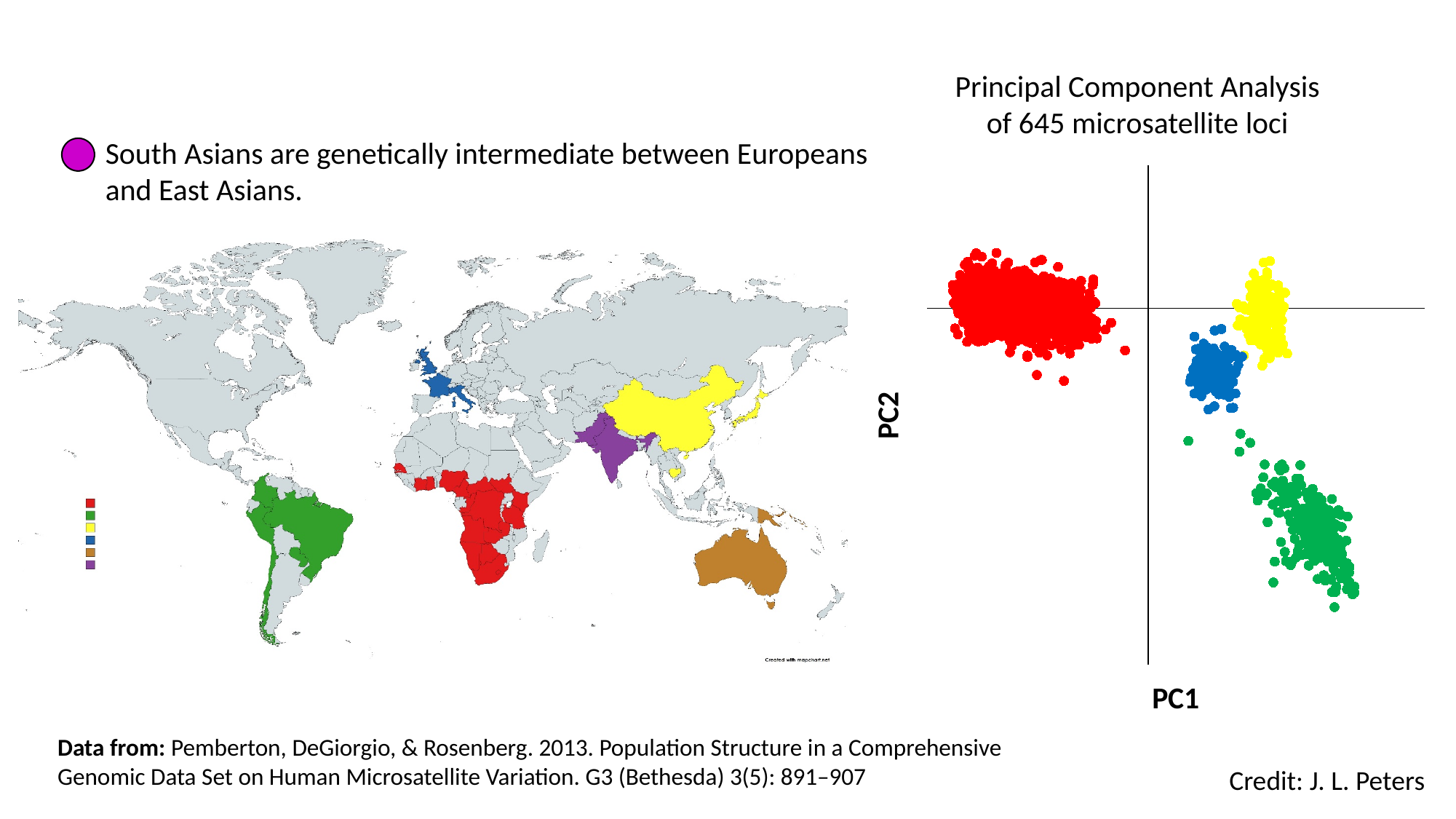
How many distinct coloured clusters of points are shown in the Principal Component Analysis chart? 4 In the Principal Component Analysis chart, which coloured cluster lies lowest along PC2? green In the Principal Component Analysis chart, which coloured cluster lies furthest to the left along PC1? red In the Principal Component Analysis chart, is the red cluster to the left or right of the vertical PC2 axis line? left In the Principal Component Analysis chart, is the blue cluster positioned higher or lower on PC2 than the yellow cluster? lower How many microsatellite loci does the title of the Principal Component Analysis chart say were analysed? 645 What is the title of the chart on the right of the slide? Principal Component Analysis of 645 microsatellite loci What kind of chart is the Principal Component Analysis chart on the right of the slide? scatter plot What is the label of the vertical axis of the Principal Component Analysis chart? PC2 What is the label of the horizontal axis of the Principal Component Analysis chart? PC1